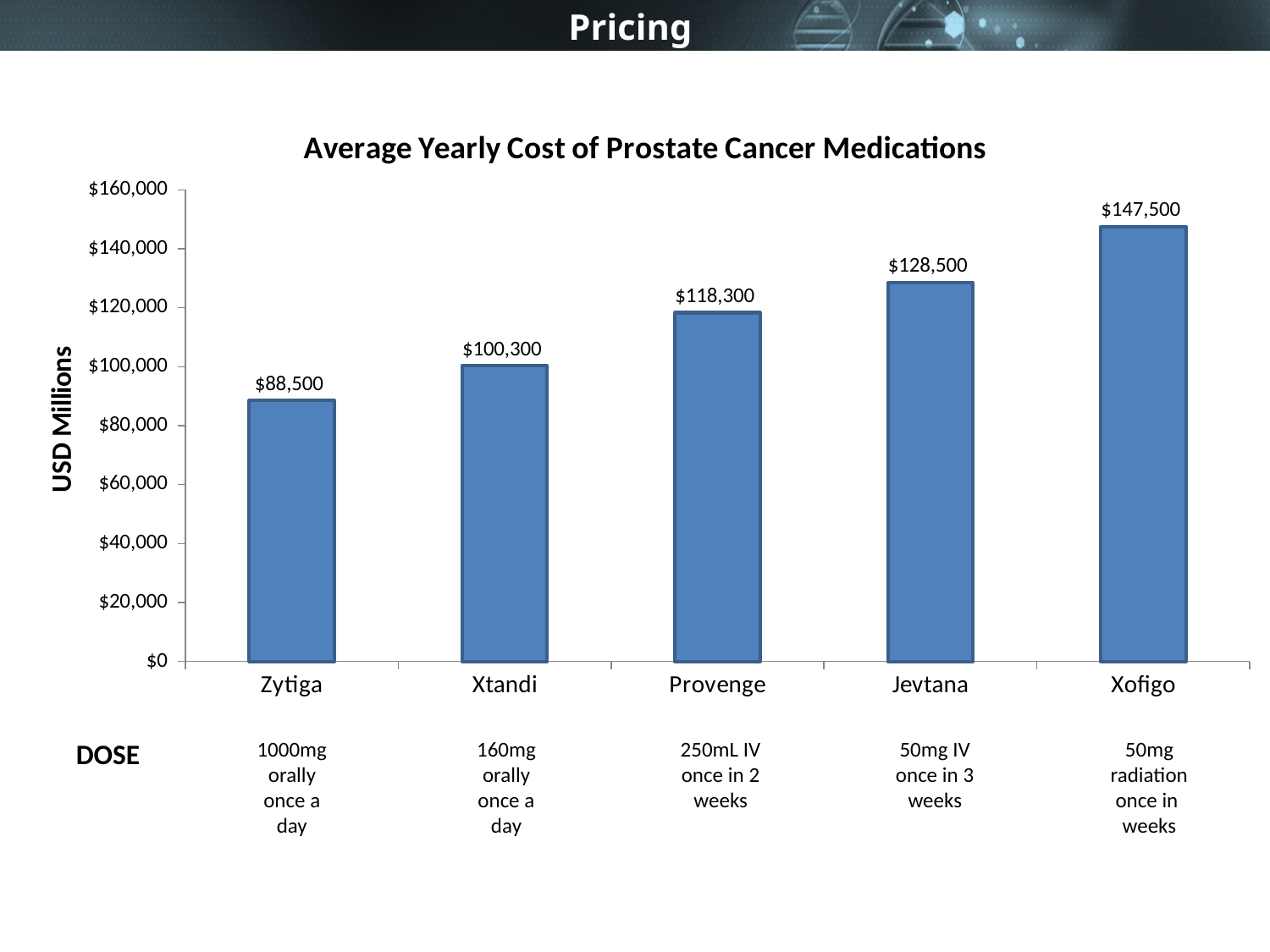
What is the average yearly cost shown for Jevtana? $128,500 How many medications are shown in the chart? 5 Which has a higher average yearly cost, Xtandi or Provenge? Provenge What is the difference in average yearly cost between Jevtana and Xtandi? $28,200 Do the values rise or fall from left to right across the medications? Rise Which medication has the highest average yearly cost? Xofigo What kind of chart is used to show the average yearly cost of prostate cancer medications? Bar chart Which medication has the lowest average yearly cost? Zytiga What is the difference in average yearly cost between Xofigo and Zytiga? $59,000 What is the average yearly cost shown for Zytiga? $88,500 What is the average yearly cost shown for Provenge? $118,300 Is the value for Xofigo greater or less than $140,000? greater